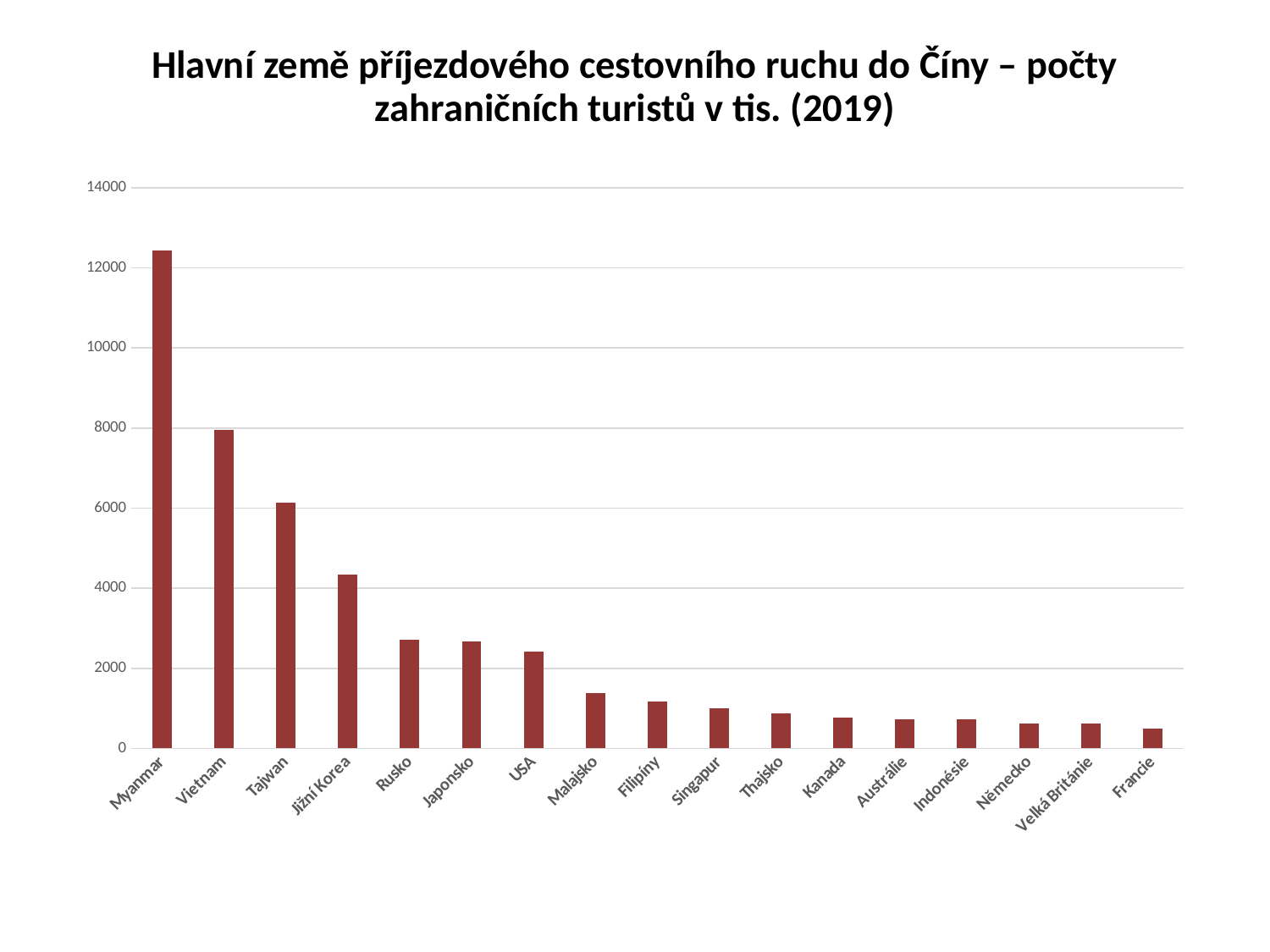
Which country has the lowest number of tourists in the chart? Francie Is the value for USA greater or less than 2000? greater Is the value for Myanmar greater or less than 12000? greater Which has a larger value, Tajwan or Jižní Korea? Tajwan Is the value for Tajwan greater or less than 6000? greater Do the values rise or fall moving from left to right along the x axis? fall How many countries are shown on the x axis of the chart? 17 What year is given in the chart title? 2019 Which country has the highest number of tourists in the chart? Myanmar What kind of chart is shown on the slide? bar chart